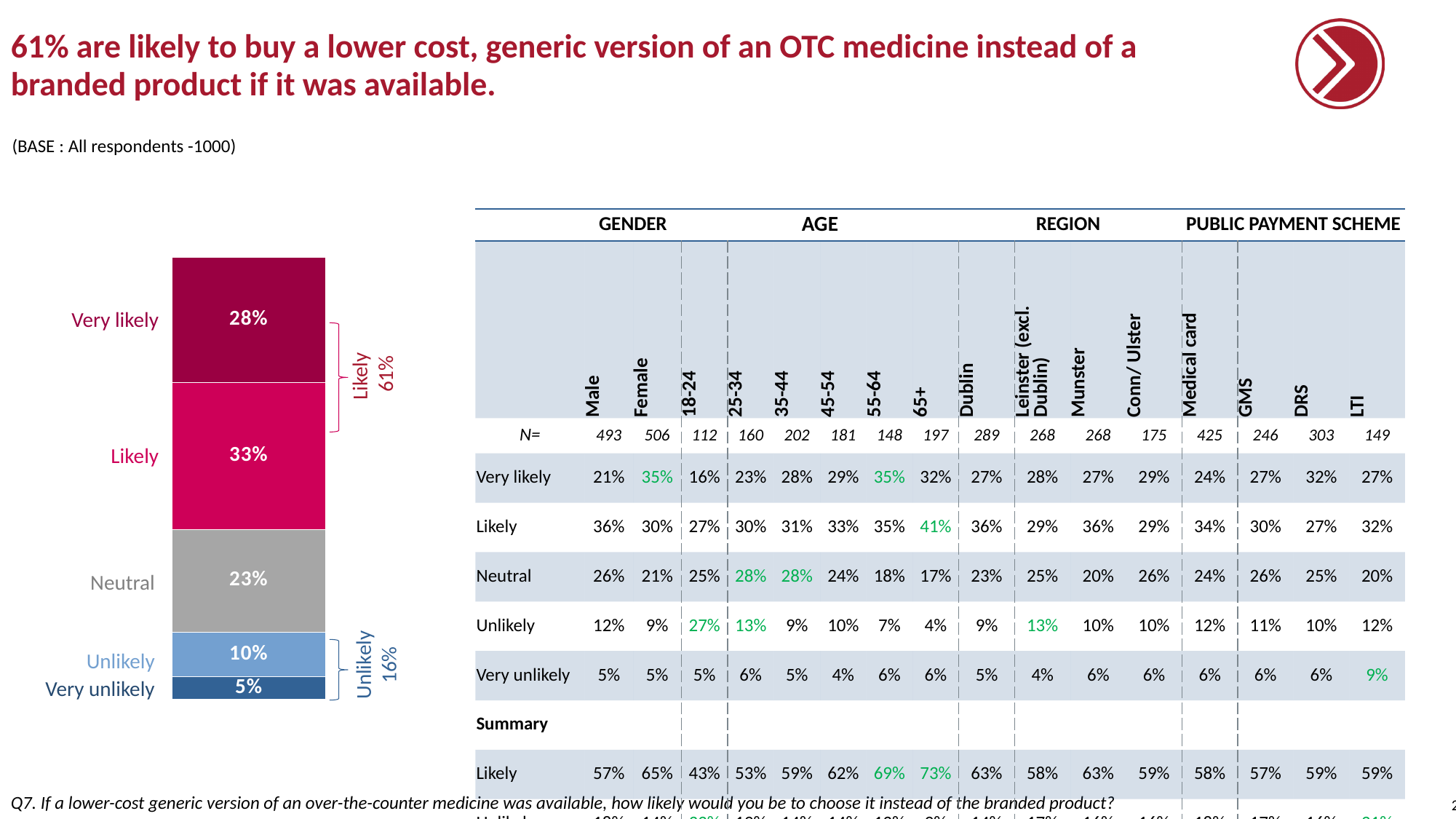
Which response category has the smallest share in the stacked bar chart? Very unlikely What type of chart is shown on the left of the slide? Stacked bar chart Which is larger in the stacked bar chart, 'Neutral' or 'Unlikely'? Neutral How many response categories are shown in the stacked bar chart? 5 What percentage of respondents are 'Very unlikely' in the stacked bar chart? 5% What is the combined share of 'Unlikely' and 'Very unlikely' shown by the bracket on the stacked bar chart? 16% What is the difference between the 'Likely' and 'Very likely' shares in the stacked bar chart? 5% Which response category has the largest share in the stacked bar chart? Likely What percentage of respondents are 'Very likely' to buy a lower cost generic OTC medicine, according to the stacked bar chart? 28% What percentage of respondents are 'Neutral' in the stacked bar chart? 23% What is the combined share of 'Very likely' and 'Likely' shown by the bracket on the stacked bar chart? 61% What percentage of respondents are 'Likely' in the stacked bar chart? 33%